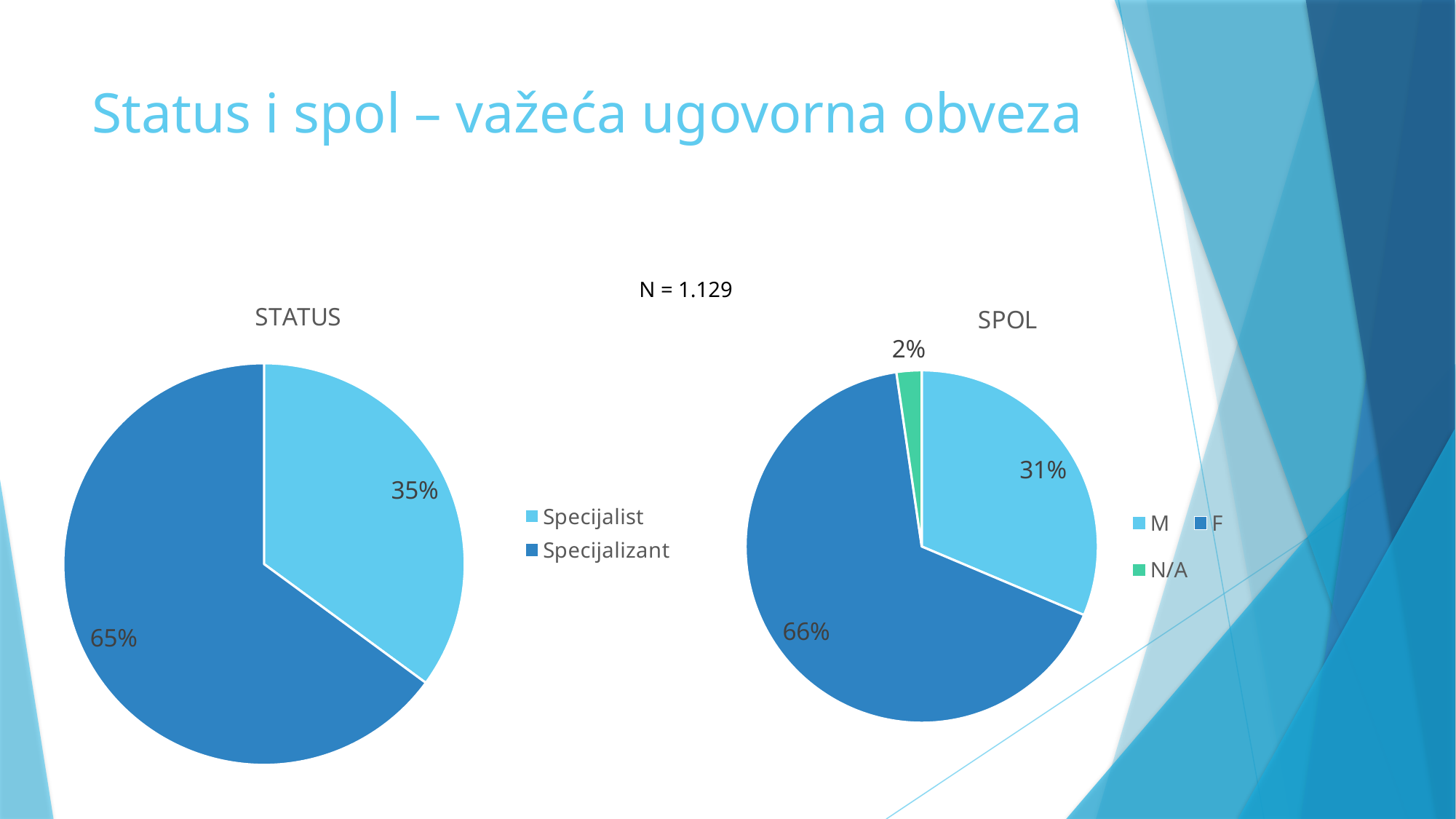
In the SPOL pie chart, which is larger, the M slice or the F slice? F How many entries does the legend of the STATUS chart list? 2 In the STATUS pie chart, what share is labelled for Specijalizant? 65% In the STATUS pie chart, what is the difference between the Specijalizant and Specijalist shares? 30% In the SPOL pie chart, what share is labelled for M? 31% How many slices does the SPOL pie chart have? 3 What type of chart is the STATUS chart? Pie chart In the SPOL pie chart, what share is labelled for F? 66% In the STATUS pie chart, which category has the largest slice? Specijalizant In the SPOL pie chart, which category has the smallest slice? N/A